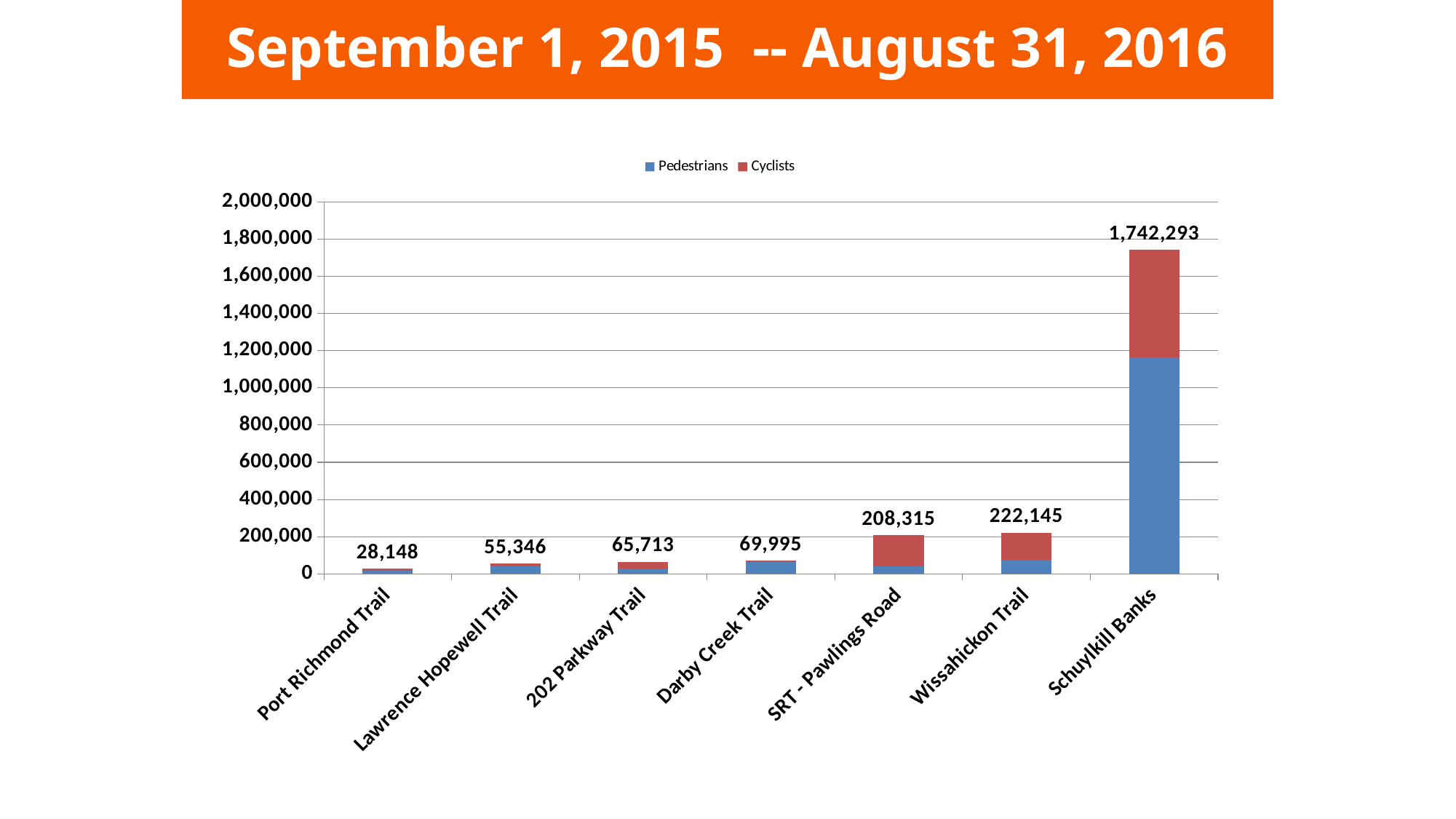
What is the total value shown for Port Richmond Trail? 28,148 Which trail has the highest total? Schuylkill Banks What kind of chart is shown on the slide? Stacked bar chart What is the total value shown for SRT - Pawlings Road? 208,315 What is the difference between the totals for Wissahickon Trail and SRT - Pawlings Road? 13,830 Is the Pedestrians value for Schuylkill Banks greater or less than 1,000,000? greater What is the total value shown for Schuylkill Banks? 1,742,293 How many trails are shown on the x axis? 7 Which trail has the lowest total? Port Richmond Trail Which has a larger total, Darby Creek Trail or 202 Parkway Trail? Darby Creek Trail How many series does the legend list? 2 Do the bar totals rise or fall from left to right along the x axis? Rise